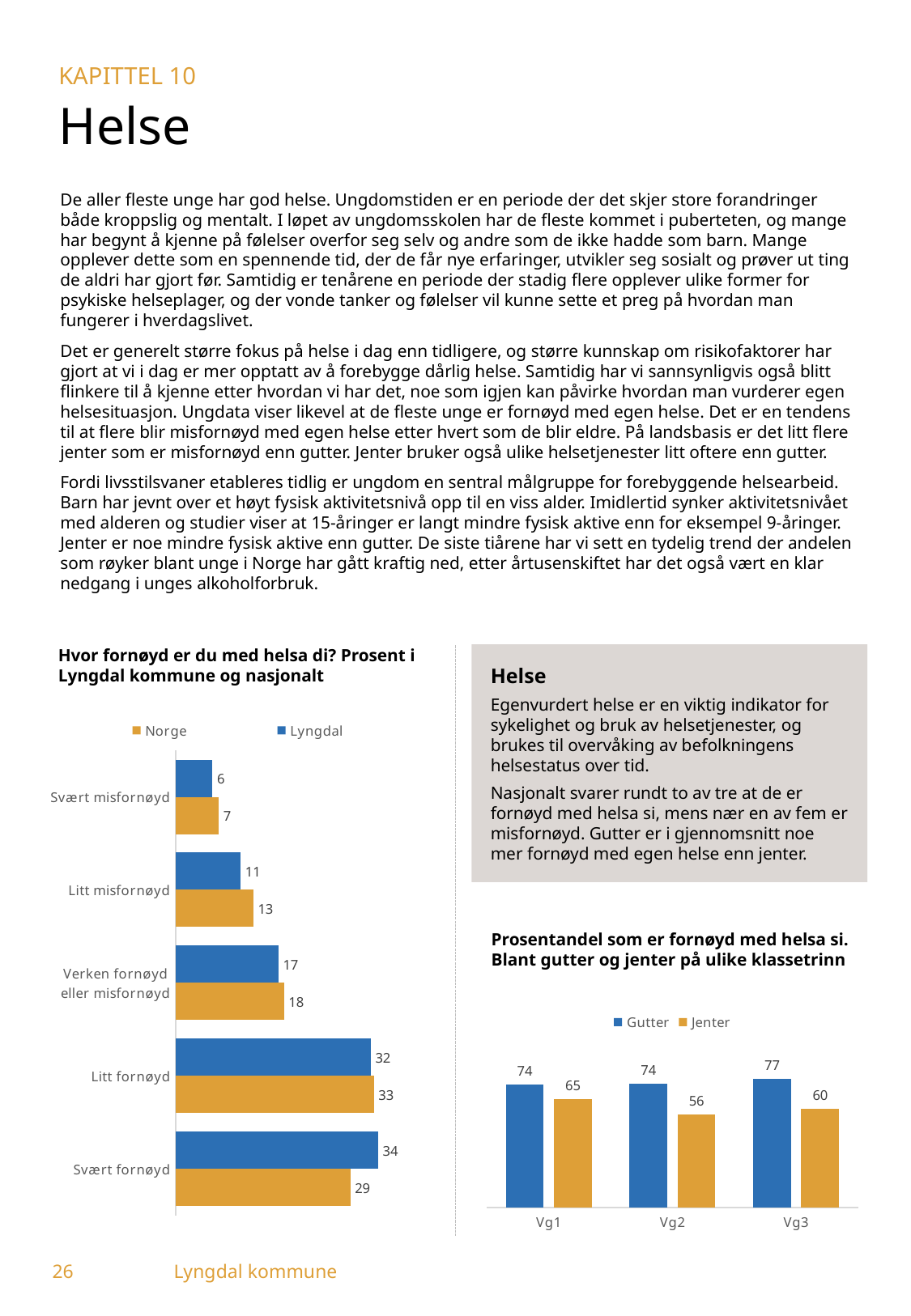
What kind of chart is 'Prosentandel som er fornøyd med helsa si'? Bar chart In the chart 'Prosentandel som er fornøyd med helsa si', what is the difference between Gutter and Jenter at Vg3? 17 In the chart 'Prosentandel som er fornøyd med helsa si', which class level has the highest value for Gutter? Vg3 In the chart 'Hvor fornøyd er du med helsa di?', what is the value for Norge in the category 'Litt misfornøyd'? 13 In the chart 'Hvor fornøyd er du med helsa di?', how many categories are shown? 5 In the chart 'Hvor fornøyd er du med helsa di?', what is the difference between the Lyngdal and Norge values for 'Svært fornøyd'? 5 In the chart 'Prosentandel som er fornøyd med helsa si', which is larger at Vg1: Gutter or Jenter? Gutter In the chart 'Hvor fornøyd er du med helsa di?', which category has the highest value for Norge? Litt fornøyd In the chart 'Hvor fornøyd er du med helsa di?', what is the value for Lyngdal in the category 'Svært fornøyd'? 34 In the chart 'Hvor fornøyd er du med helsa di?', how many series does the legend list? 2 In the chart 'Prosentandel som er fornøyd med helsa si', what is the value for Jenter at Vg2? 56 In the chart 'Hvor fornøyd er du med helsa di?', which category has the lowest value for Lyngdal? Svært misfornøyd